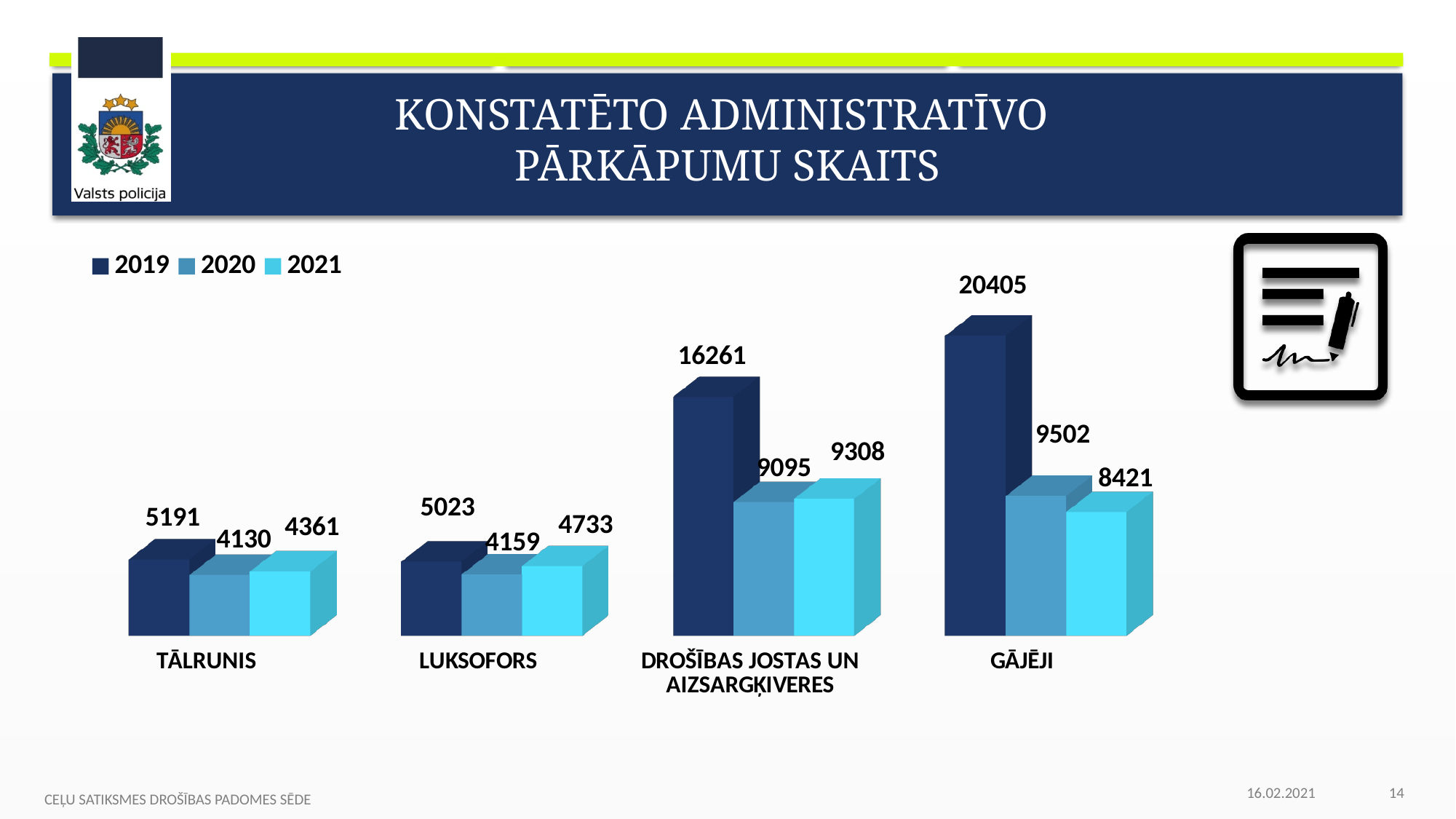
What is the title of the chart? KONSTATĒTO ADMINISTRATĪVO PĀRKĀPUMU SKAITS What kind of chart is shown on the slide? Bar chart How many categories are shown on the x axis? 4 Which category has the lowest value in 2020? TĀLRUNIS What is the value for GĀJĒJI in 2021? 8421 How many series does the legend list? 3 What is the value for TĀLRUNIS in 2019? 5191 What is the value for DROŠĪBAS JOSTAS UN AIZSARGĶIVERES in 2020? 9095 Which category has the highest value in 2019? GĀJĒJI What is the difference between the 2019 and 2021 values for GĀJĒJI? 11984 What is the value for LUKSOFORS in 2021? 4733 Which is larger for LUKSOFORS: the 2020 value or the 2021 value? 2021